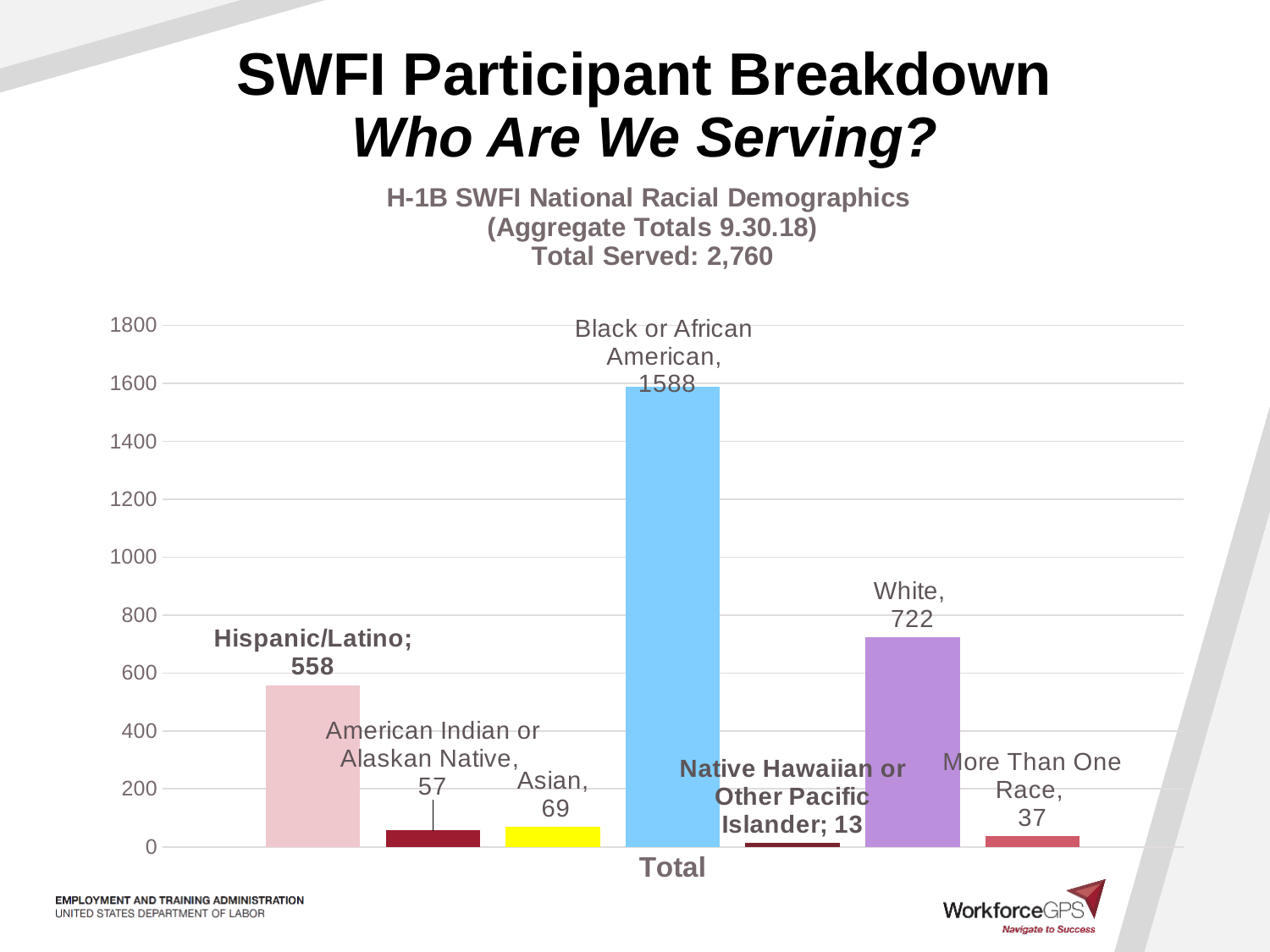
What is the value for Black or African American? 1588 Is the value for White greater or less than 600? greater What is the difference between the values for Black or African American and White? 866 What is the value for Native Hawaiian or Other Pacific Islander? 13 What kind of chart is shown on the slide? bar chart What is the value for Hispanic/Latino? 558 Which category has the highest value? Black or African American What total served figure is stated in the chart title? 2,760 How many categories are plotted in the chart? 7 What is the value for White? 722 Which category has the lowest value? Native Hawaiian or Other Pacific Islander Which is larger, the value for Asian or the value for American Indian or Alaskan Native? Asian